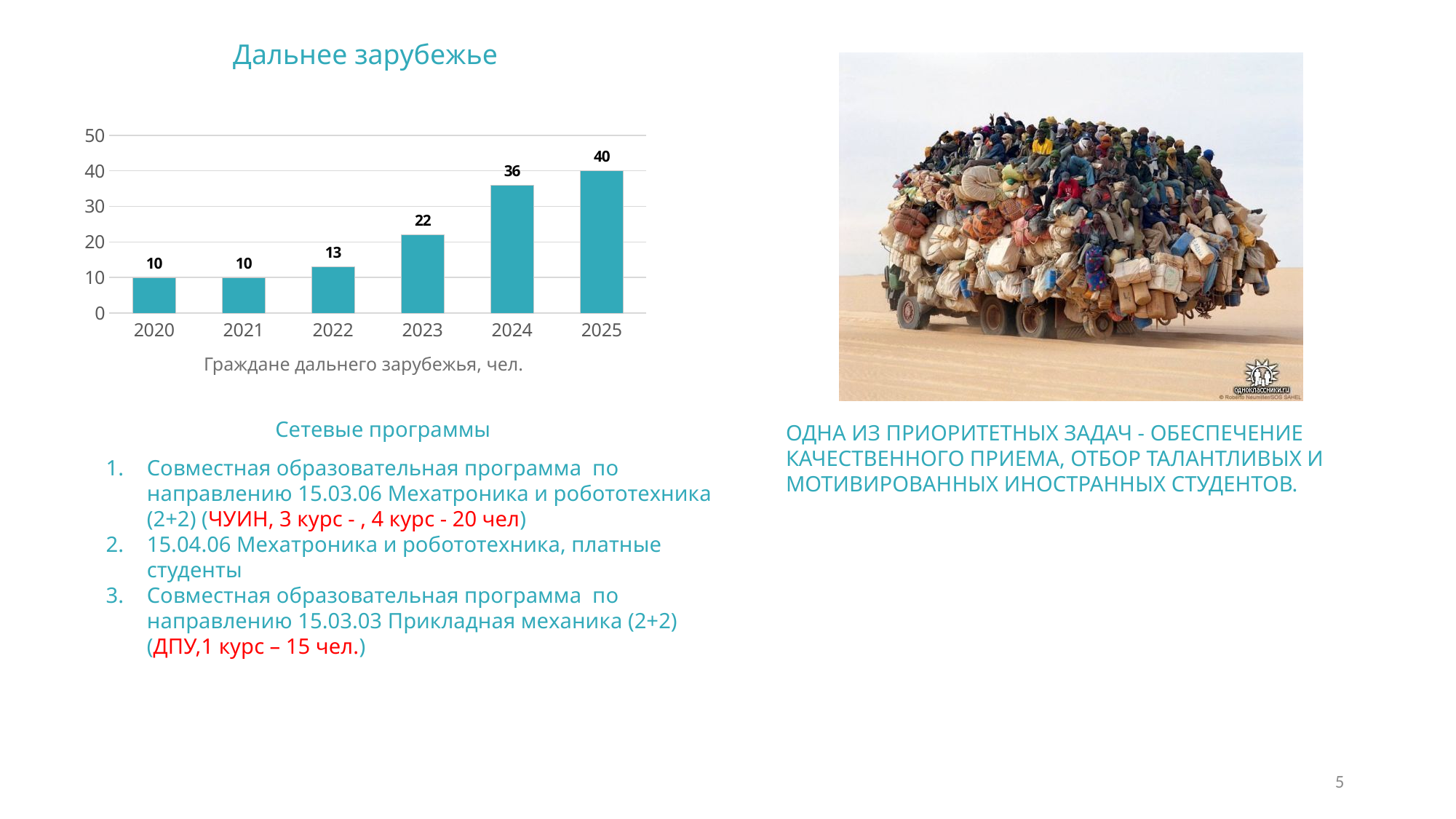
Do the values in the chart rise or fall from 2020 to 2025? rise What is the difference between the values for 2025 and 2024? 4 What is the legend entry shown below the chart? Граждане дальнего зарубежья, чел. Which year has the highest value in the chart? 2025 What is the value for 2025 in the chart? 40 How many years are shown on the x axis of the chart? 6 What is the difference between the values for 2024 and 2023? 14 Which is larger, the value for 2022 or the value for 2023? 2023 What kind of chart is shown on the slide? bar chart What is the value for 2023 in the chart? 22 Is the value for 2024 greater or less than 30? greater What is the value for 2022 in the chart? 13